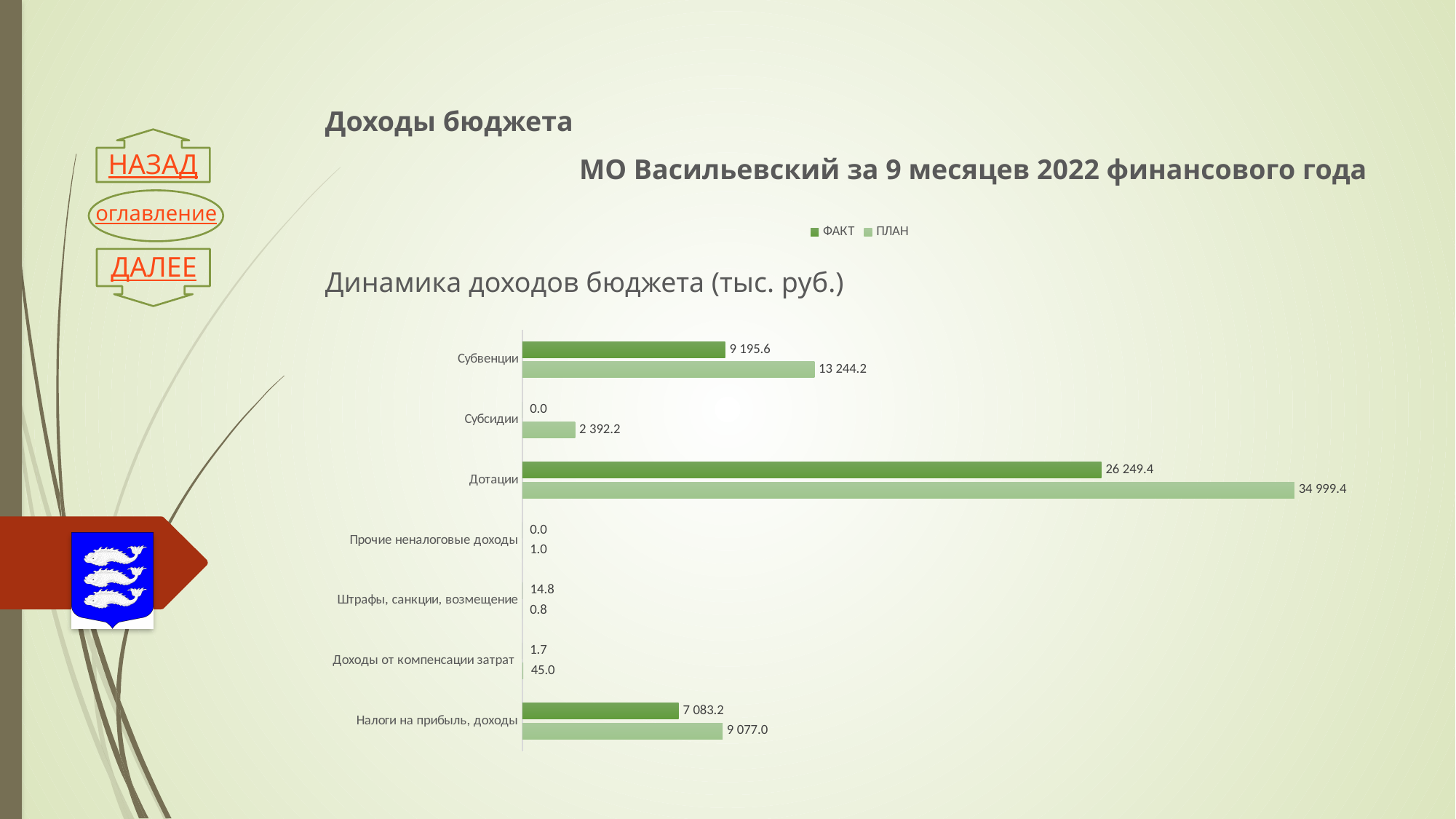
Which category has the highest ПЛАН value? Дотации What are the two series named in the chart legend? ФАКТ and ПЛАН What type of chart is shown on the slide? bar chart Which category has the lowest ПЛАН value? Штрафы, санкции, возмещение What is the ПЛАН value for Субвенции? 13 244.2 What is the ПЛАН value for Доходы от компенсации затрат? 45.0 What is the difference between the ПЛАН and ФАКТ values for Дотации? 8 750.0 What is the ФАКТ value for Дотации? 26 249.4 How many categories are shown on the chart? 7 How many series does the chart legend list? 2 Which is larger for Налоги на прибыль, доходы: the ФАКТ value or the ПЛАН value? ПЛАН What is the ФАКТ value for Штрафы, санкции, возмещение? 14.8